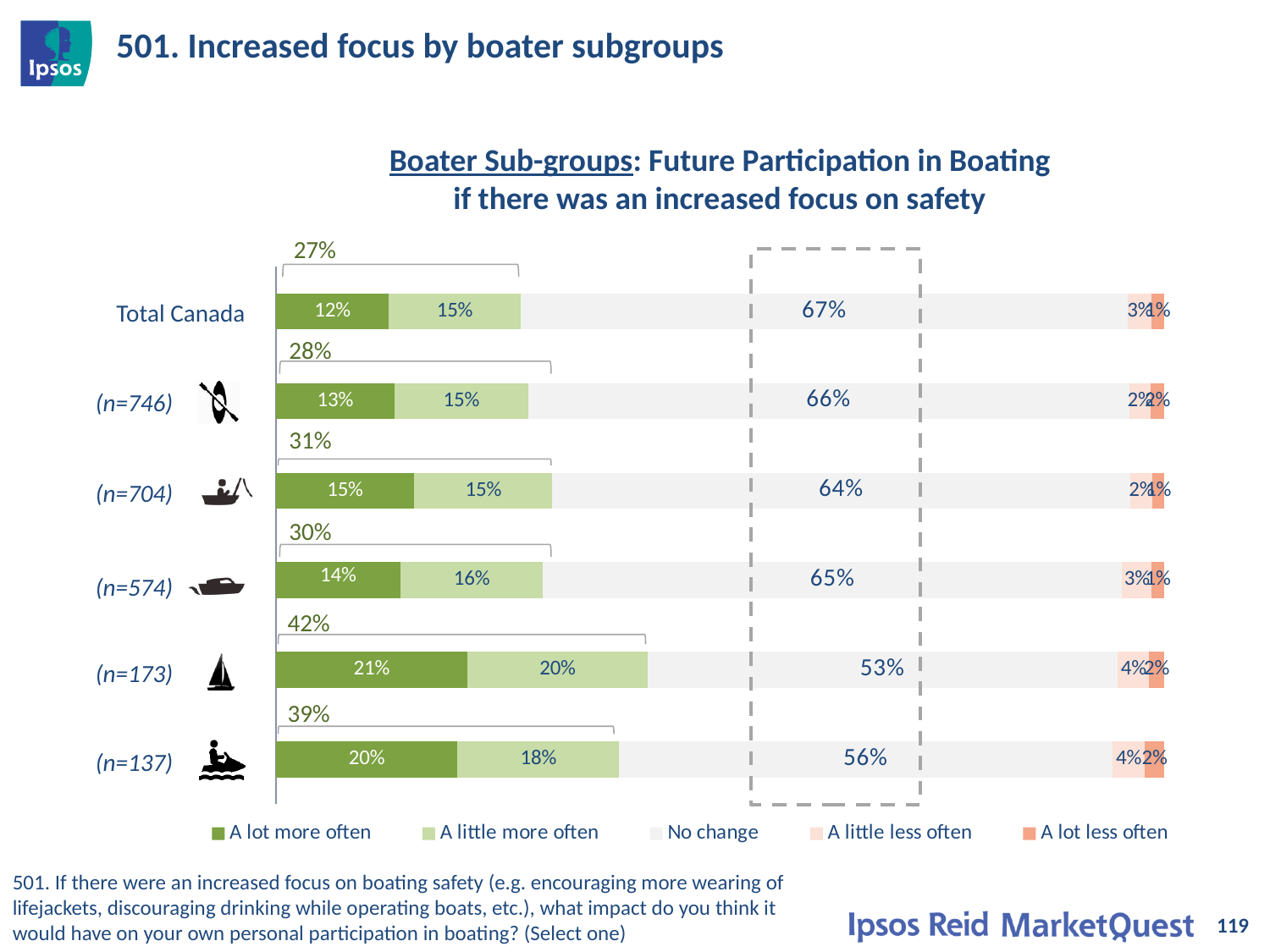
Which group has the highest 'No change' value? Total Canada Which is larger: the 'A little more often' value for (n=574) or for (n=746)? (n=574) How much higher is the 'A lot more often' value for (n=173) than for Total Canada? 9 percentage points How many boater groups (rows) are plotted in the chart? 6 What combined percentage is shown above the bar for the (n=137) group? 39% What is the 'No change' value for Total Canada? 67% What is the 'A lot more often' value for the (n=173) group? 21% How many series does the legend list? 5 What is the 'A little more often' value for the (n=137) group? 18% Which group has the lowest 'No change' value? (n=173) What kind of chart is shown on the slide? bar chart What is the first entry in the chart legend? A lot more often